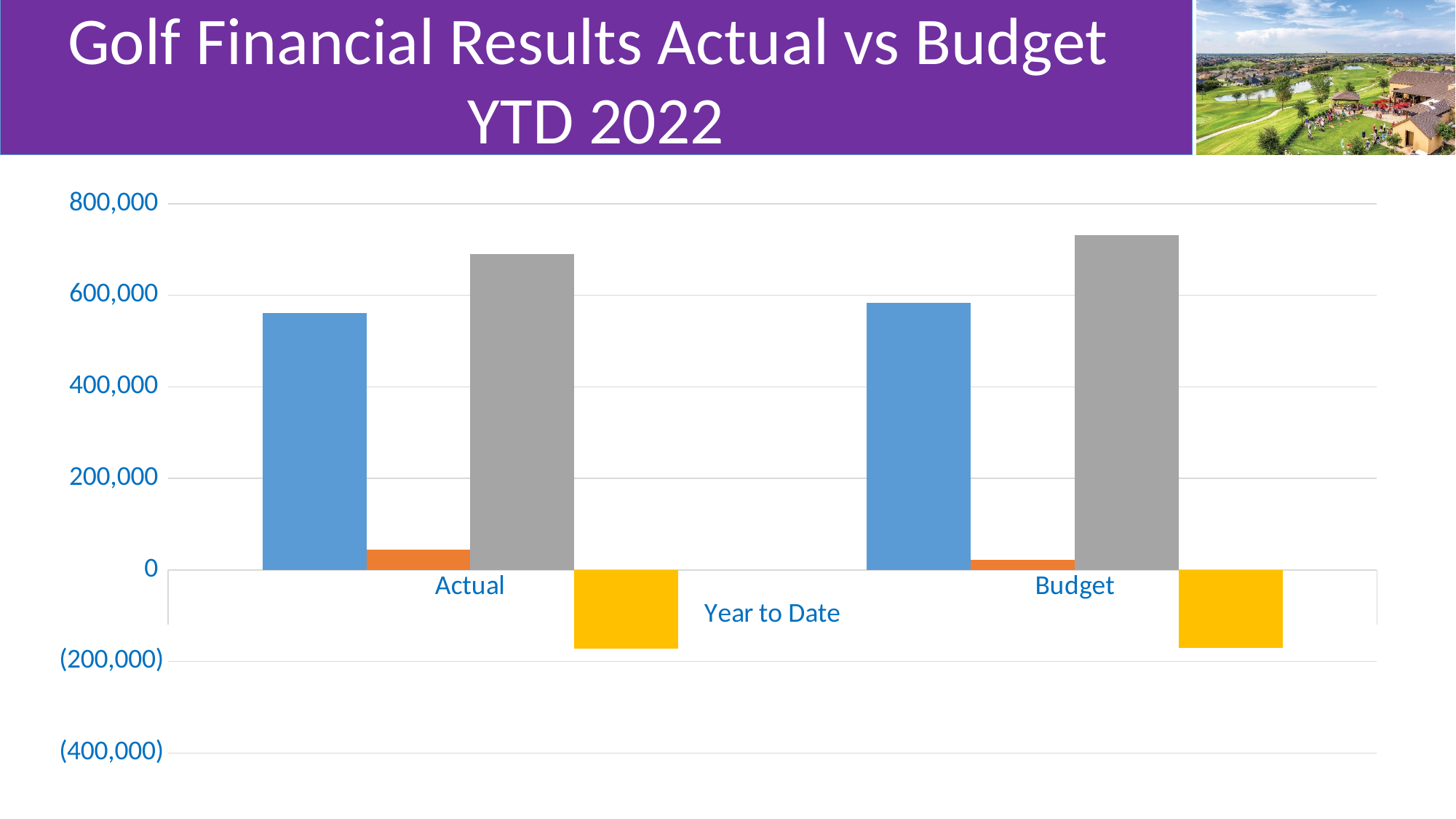
What are the two categories shown on the x axis? Actual and Budget Is the value of the gray bar for Budget greater or less than 600,000? greater Which bar in the Actual category is the tallest? the gray bar Is the value of the orange bar for Budget greater or less than 200,000? less Is the value of the yellow bar for Actual greater or less than 0? less Which is larger, the gray bar for Actual or the gray bar for Budget? Budget Which is larger, the orange bar for Actual or the orange bar for Budget? Actual What is the title of the slide containing the chart? Golf Financial Results Actual vs Budget YTD 2022 How many categories are shown on the x axis of the chart? 2 What kind of chart is shown on the slide? bar chart